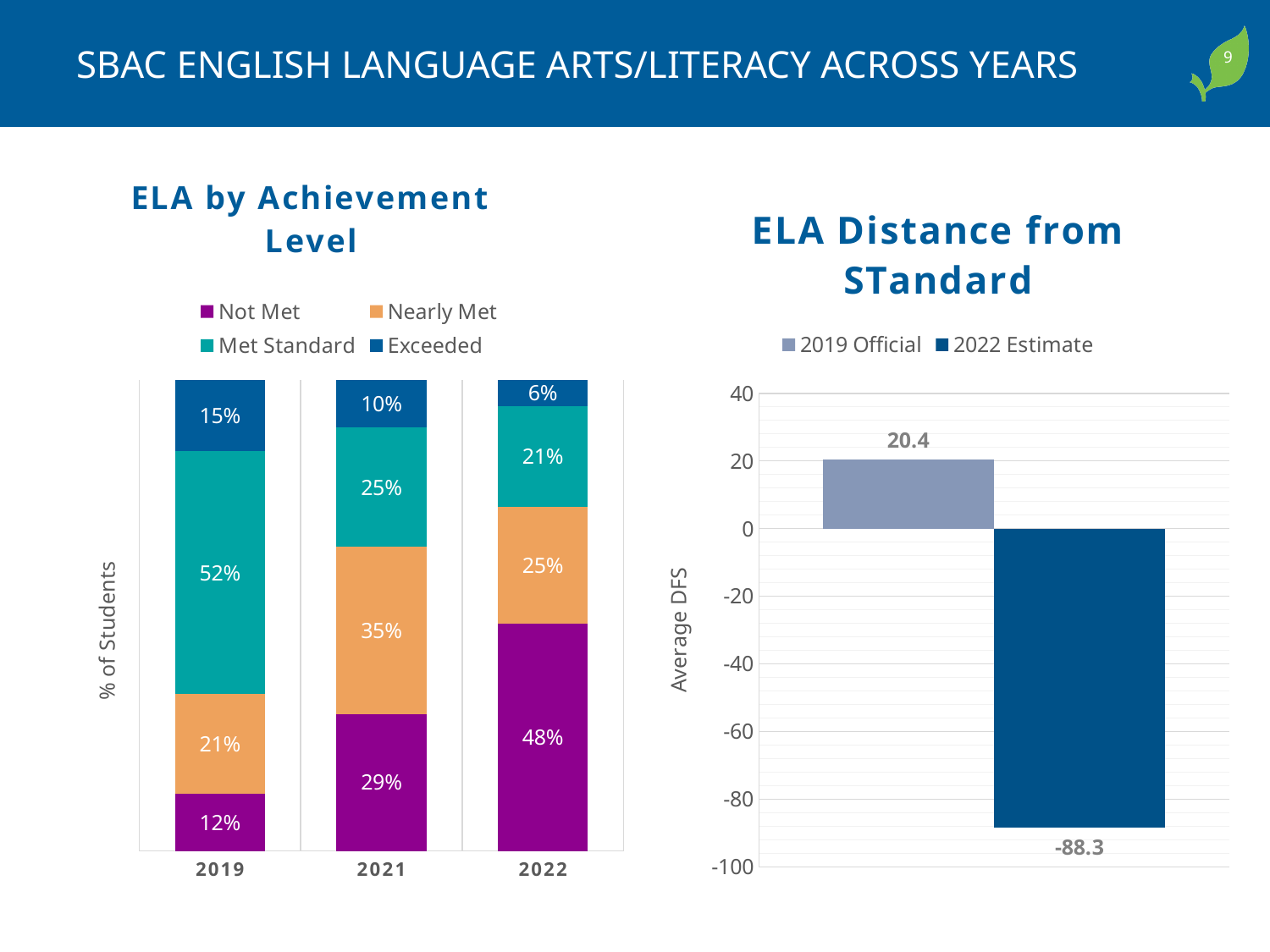
In the 'ELA by Achievement Level' chart, what is the difference between the Not Met percentage in 2022 and in 2019? 36% In the 'ELA by Achievement Level' chart, which year has the highest Exceeded percentage? 2019 In the 'ELA by Achievement Level' chart, does the Exceeded percentage rise or fall from 2019 to 2022? fall In the 'ELA by Achievement Level' chart, what percentage of students were in the Nearly Met level in 2021? 35% In the 'ELA Distance from STandard' chart, what is the 2019 Official value? 20.4 In the 'ELA by Achievement Level' chart, how many series does the legend list? 4 In the 'ELA by Achievement Level' chart, what percentage of students were in the Not Met level in 2022? 48% In the 'ELA by Achievement Level' chart, what percentage of students Met Standard in 2019? 52% In the 'ELA Distance from STandard' chart, what is the 2022 Estimate value? -88.3 What kind of chart is the 'ELA Distance from STandard' chart? bar chart In the 'ELA by Achievement Level' chart, which year has the lowest Not Met percentage? 2019 In the 'ELA by Achievement Level' chart, is the Met Standard percentage larger in 2021 or in 2022? 2021